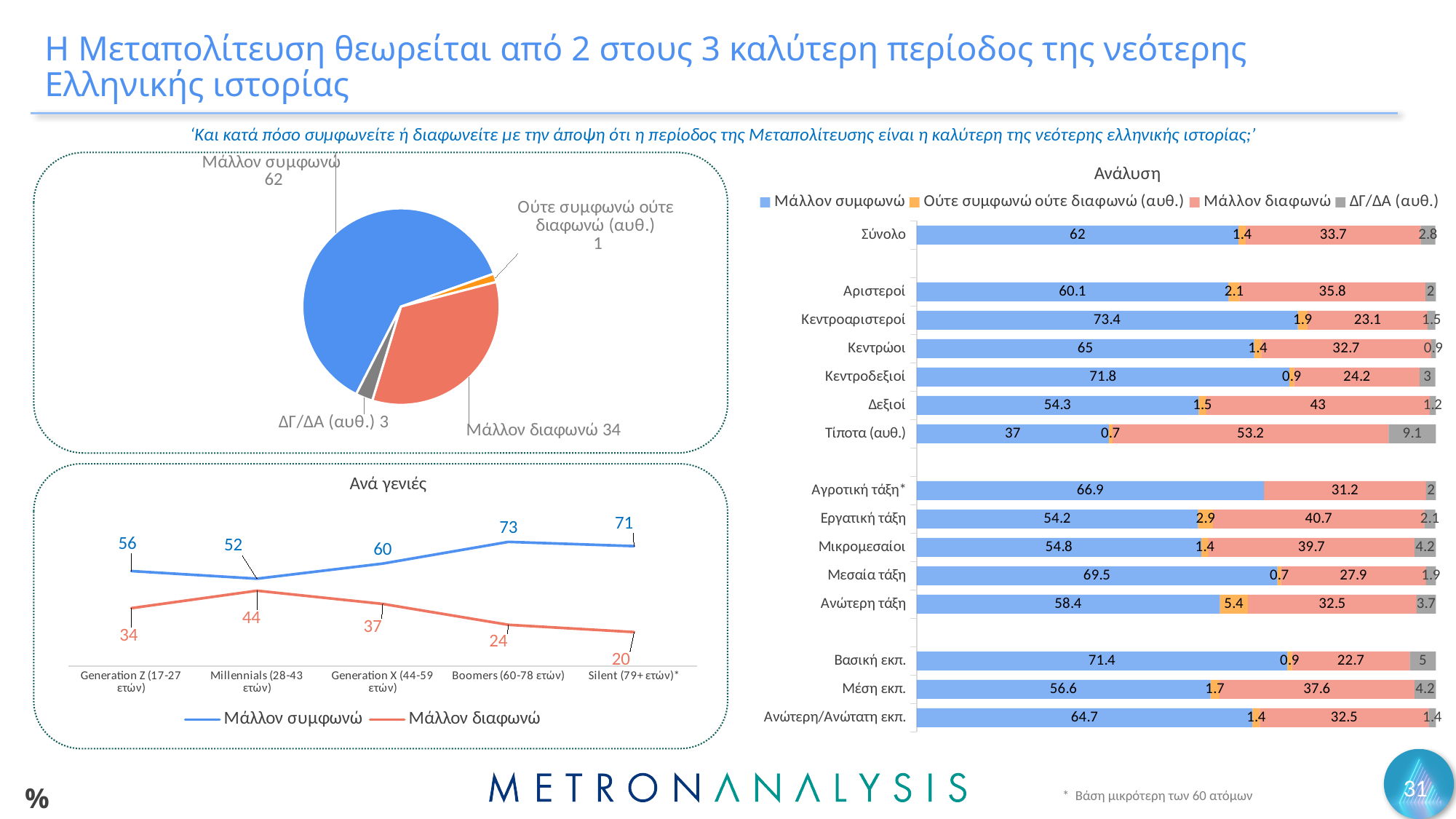
How many slices does the pie chart on the top left have? 4 In the 'Ανάλυση' chart, what is the Μάλλον διαφωνώ value for Τίποτα (αυθ.)? 53.2 What type of chart is the 'Ανά γενιές' chart? Line chart How many series does the legend of the 'Ανά γενιές' chart list? 2 In the 'Ανά γενιές' chart, what is the Μάλλον συμφωνώ value for Boomers (60-78 ετών)? 73 In the 'Ανά γενιές' chart, which generation has the highest Μάλλον διαφωνώ value? Millennials (28-43 ετών) How many series does the legend of the 'Ανάλυση' chart list? 4 In the pie chart on the top left, which category has the smallest slice? Ούτε συμφωνώ ούτε διαφωνώ (αυθ.) In the pie chart on the top left, what is the value for Μάλλον συμφωνώ? 62 In the 'Ανάλυση' chart, is the Μάλλον συμφωνώ value larger for Κεντροδεξιοί or for Δεξιοί? Κεντροδεξιοί In the 'Ανά γενιές' chart, what is the difference between Μάλλον συμφωνώ and Μάλλον διαφωνώ for Silent (79+ ετών)*? 51 In the 'Ανάλυση' chart, which category has the highest Μάλλον συμφωνώ value? Κεντροαριστεροί